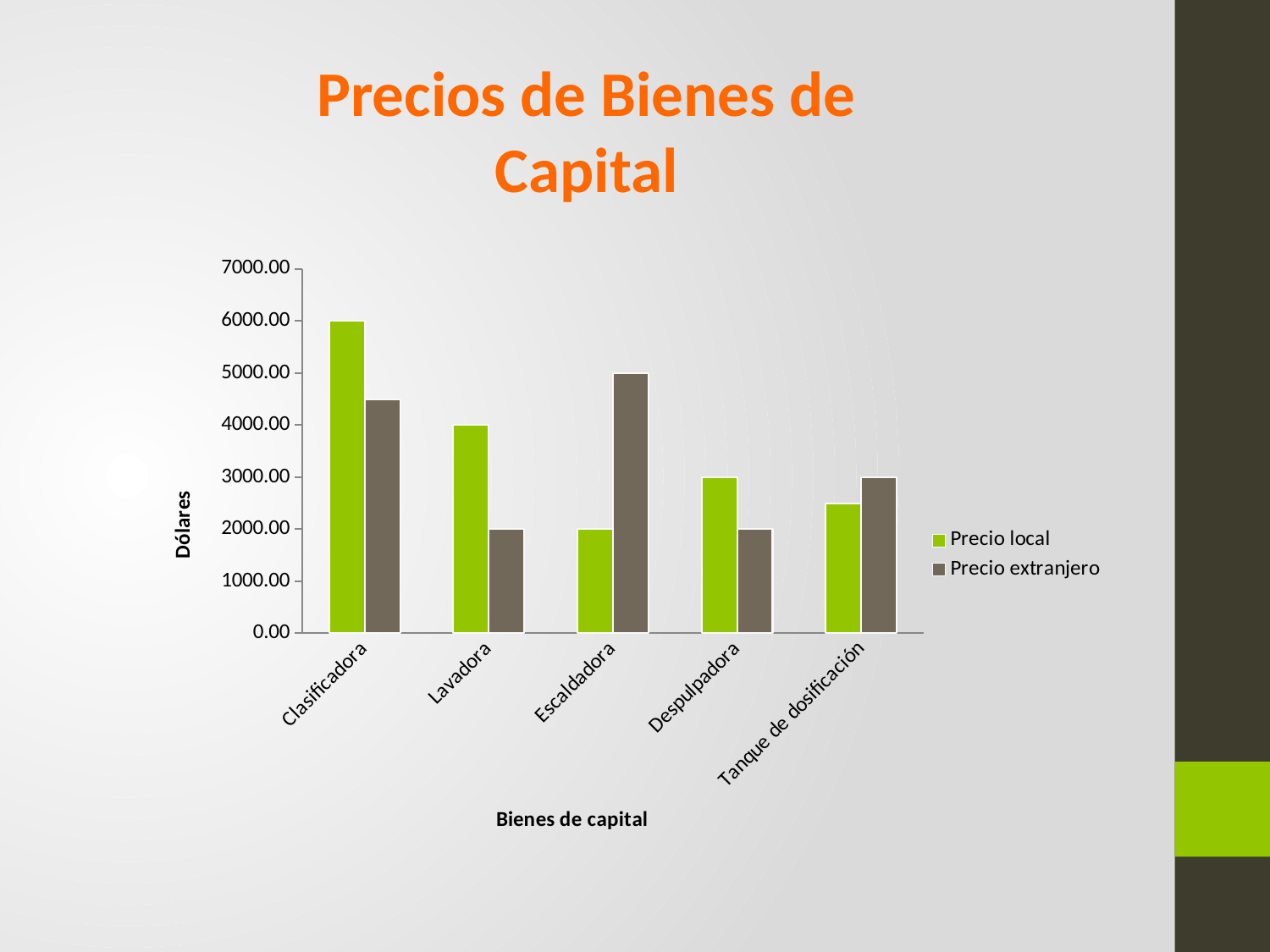
What is the label of the vertical axis? Dólares Which capital good has the highest Precio extranjero? Escaldadora What kind of chart is shown on the slide? bar chart How many series does the legend list? 2 For Escaldadora, which is larger: Precio local or Precio extranjero? Precio extranjero Is the Precio local for Clasificadora greater or less than 5000.00? greater Which capital good has the lowest Precio local? Escaldadora How many categories of capital goods are shown on the x axis? 5 Is the Precio extranjero for Lavadora greater or less than 3000.00? less For Tanque de dosificación, which is larger: Precio local or Precio extranjero? Precio extranjero For Clasificadora, which is larger: Precio local or Precio extranjero? Precio local Which capital good has the highest Precio local? Clasificadora